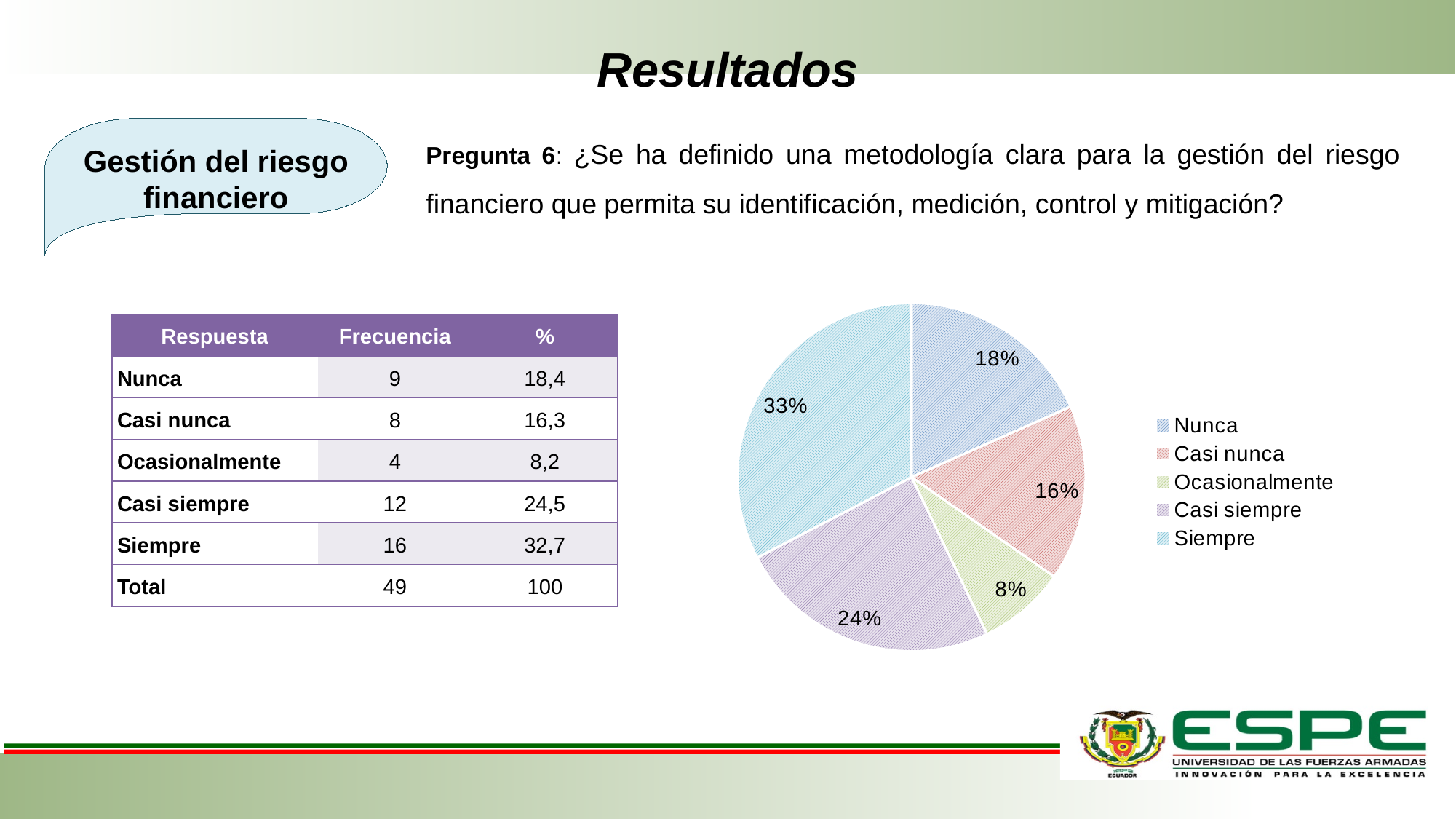
Which category has the largest slice in the pie chart? Siempre How many entries does the pie chart's legend list? 5 How many slices does the pie chart have? 5 What kind of chart is shown on the slide? pie chart What is the difference in percentage points between the Siempre slice and the Nunca slice in the pie chart? 15 What percentage does the pie chart show for Nunca? 18% What percentage does the pie chart show for Casi siempre? 24% What percentage does the pie chart show for Siempre? 33% Which slice is larger in the pie chart, Casi nunca or Casi siempre? Casi siempre Which category has the smallest slice in the pie chart? Ocasionalmente What percentage does the pie chart show for Ocasionalmente? 8% Which legend entry is listed first in the pie chart's legend? Nunca